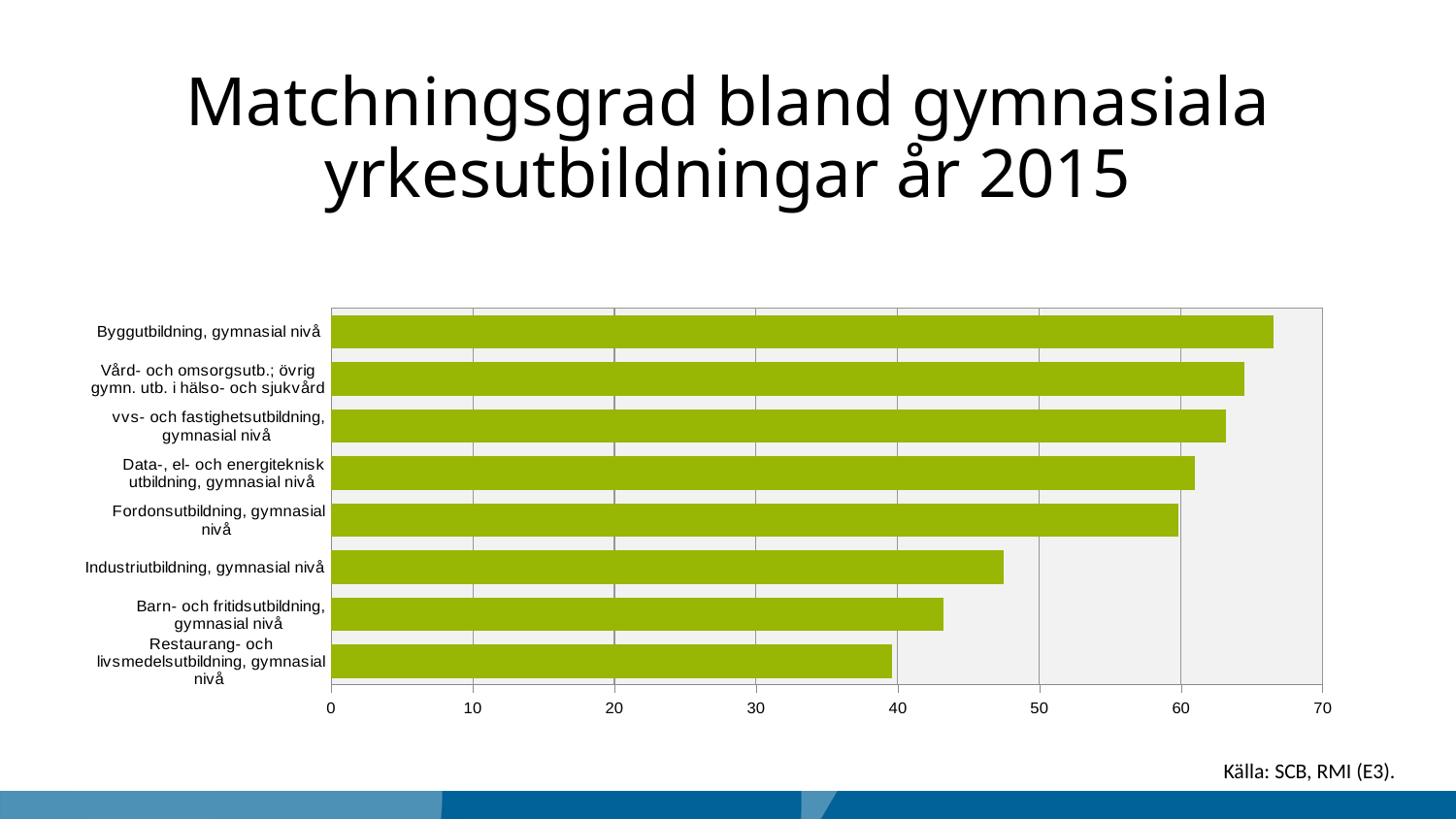
What kind of chart is shown on the slide? bar chart Is the value for Industriutbildning, gymnasial nivå greater or less than 50? less Which category has the highest matching rate in the chart? Byggutbildning, gymnasial nivå Which has a higher value: Fordonsutbildning, gymnasial nivå or Barn- och fritidsutbildning, gymnasial nivå? Fordonsutbildning, gymnasial nivå What is the title of the slide containing the chart? Matchningsgrad bland gymnasiala yrkesutbildningar år 2015 What is the maximum value shown on the horizontal axis of the chart? 70 Is the value for Fordonsutbildning, gymnasial nivå greater or less than 50? greater Which category has the lowest matching rate in the chart? Restaurang- och livsmedelsutbildning, gymnasial nivå Is the value for Barn- och fritidsutbildning, gymnasial nivå greater or less than 40? greater Which has a higher value: Byggutbildning, gymnasial nivå or Industriutbildning, gymnasial nivå? Byggutbildning, gymnasial nivå How many education categories are plotted in the chart? 8